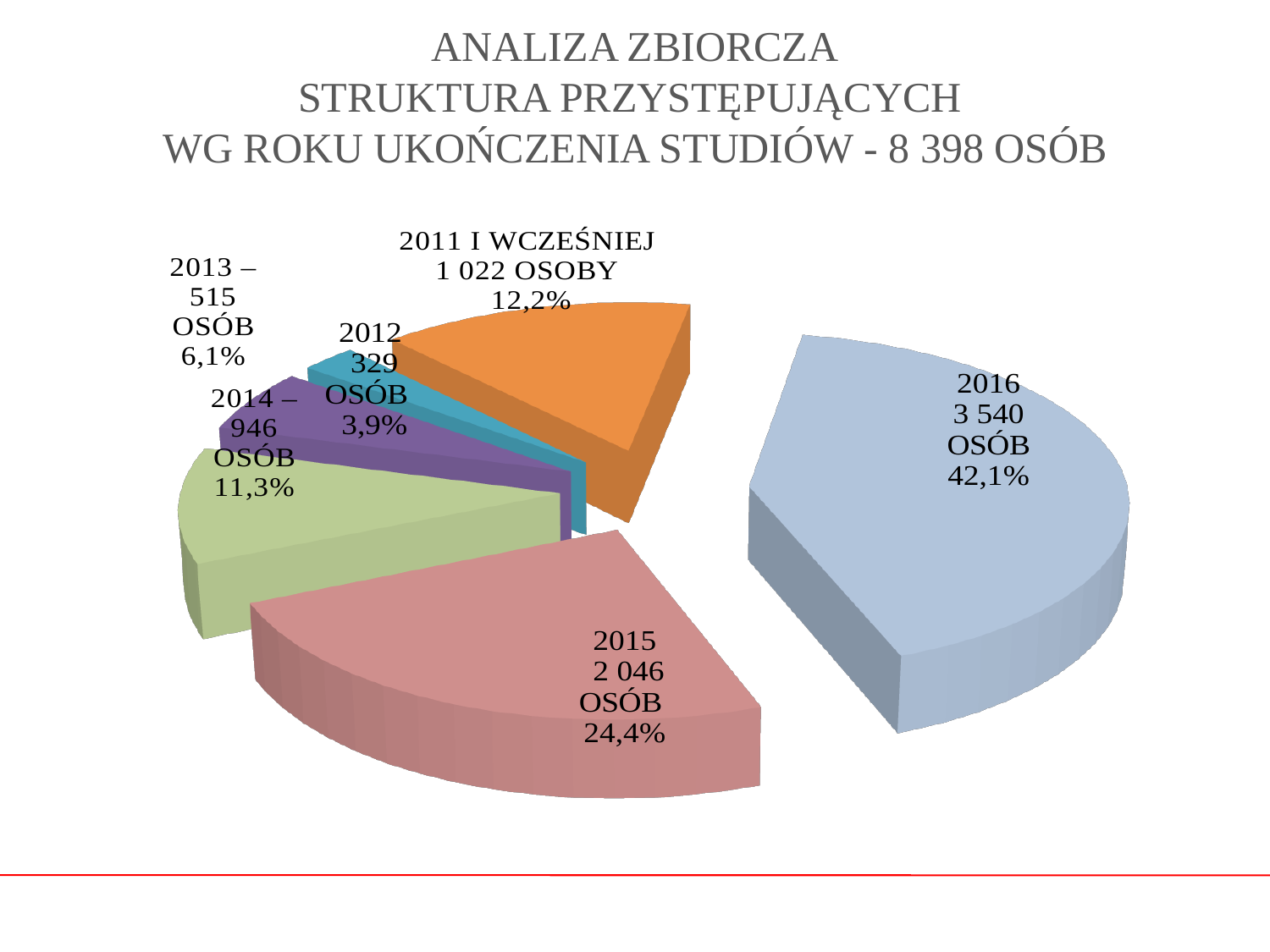
What percentage share does the 2012 slice have? 3,9% What percentage share does the 2015 slice have? 24,4% How many people (osób) are in the 2016 slice? 3 540 How many slices does the pie chart have? 6 What kind of chart is shown on the slide? pie chart What is the difference in number of people between the 2016 and 2015 slices? 1 494 What total number of people does the chart title state? 8 398 How many people are in the '2011 i wcześniej' slice? 1 022 Which year has the smallest slice of the pie? 2012 Which year has the largest slice of the pie? 2016 Which slice is larger, 2013 or 2014? 2014 How many people are in the 2014 slice? 946